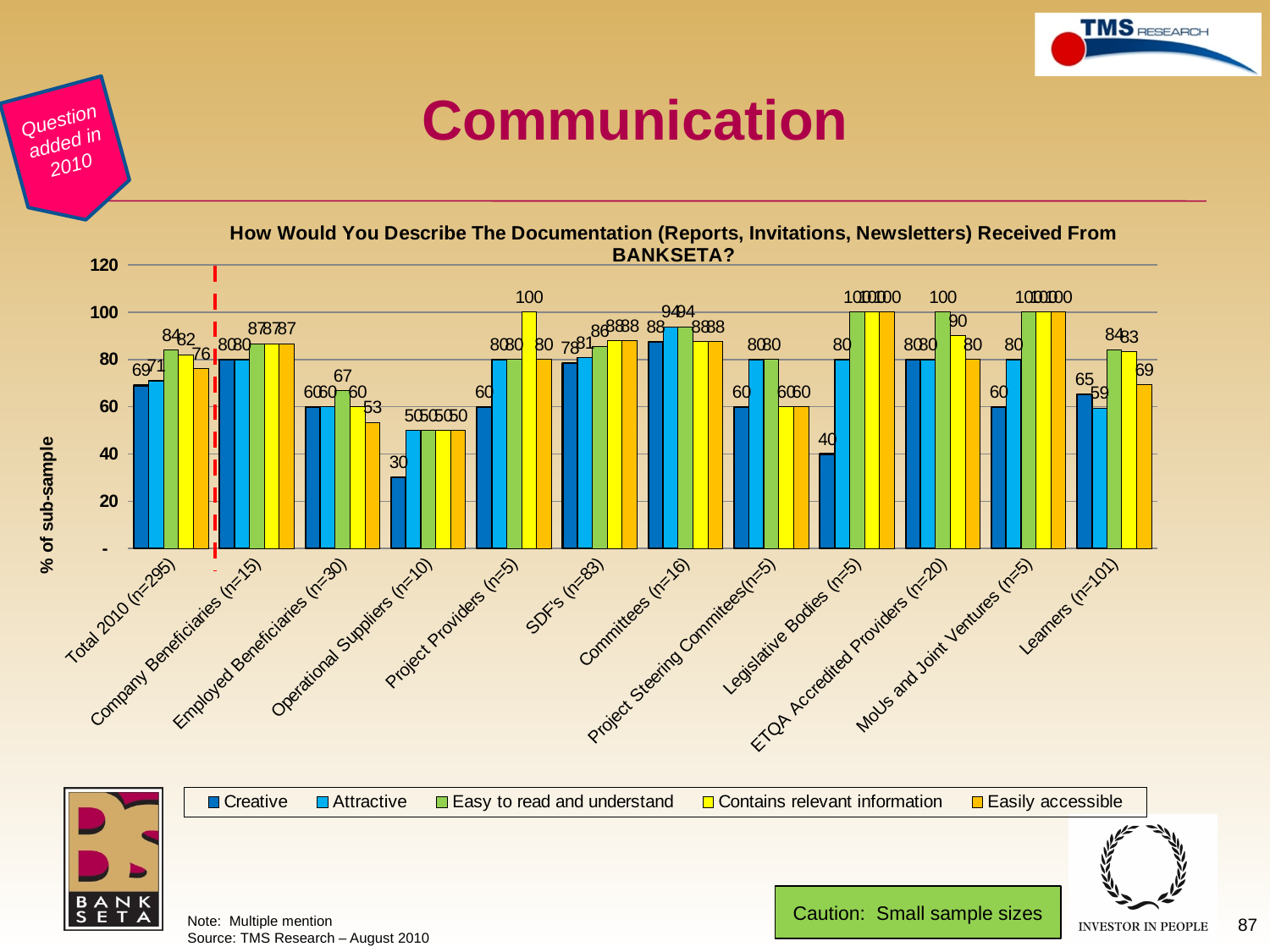
What is the value for Contains relevant information for ETQA Accredited Providers (n=20)? 90 How many categories are shown along the x axis? 12 How many series does the legend list? 5 What is the value for Easily accessible for Learners (n=101)? 69 Which category has the lowest value for Creative? Operational Suppliers (n=10) For Total 2010 (n=295), which is larger: Creative or Easily accessible? Easily accessible Is the value for Easily accessible for Employed Beneficiaries (n=30) greater or less than 60? less What is the difference between the Creative and Attractive values for Learners (n=101)? 6 What kind of chart is shown on the slide? Bar chart What is the label on the y axis? % of sub-sample What is the value for Creative for Legislative Bodies (n=5)? 40 What is the value for Creative for Operational Suppliers (n=10)? 30